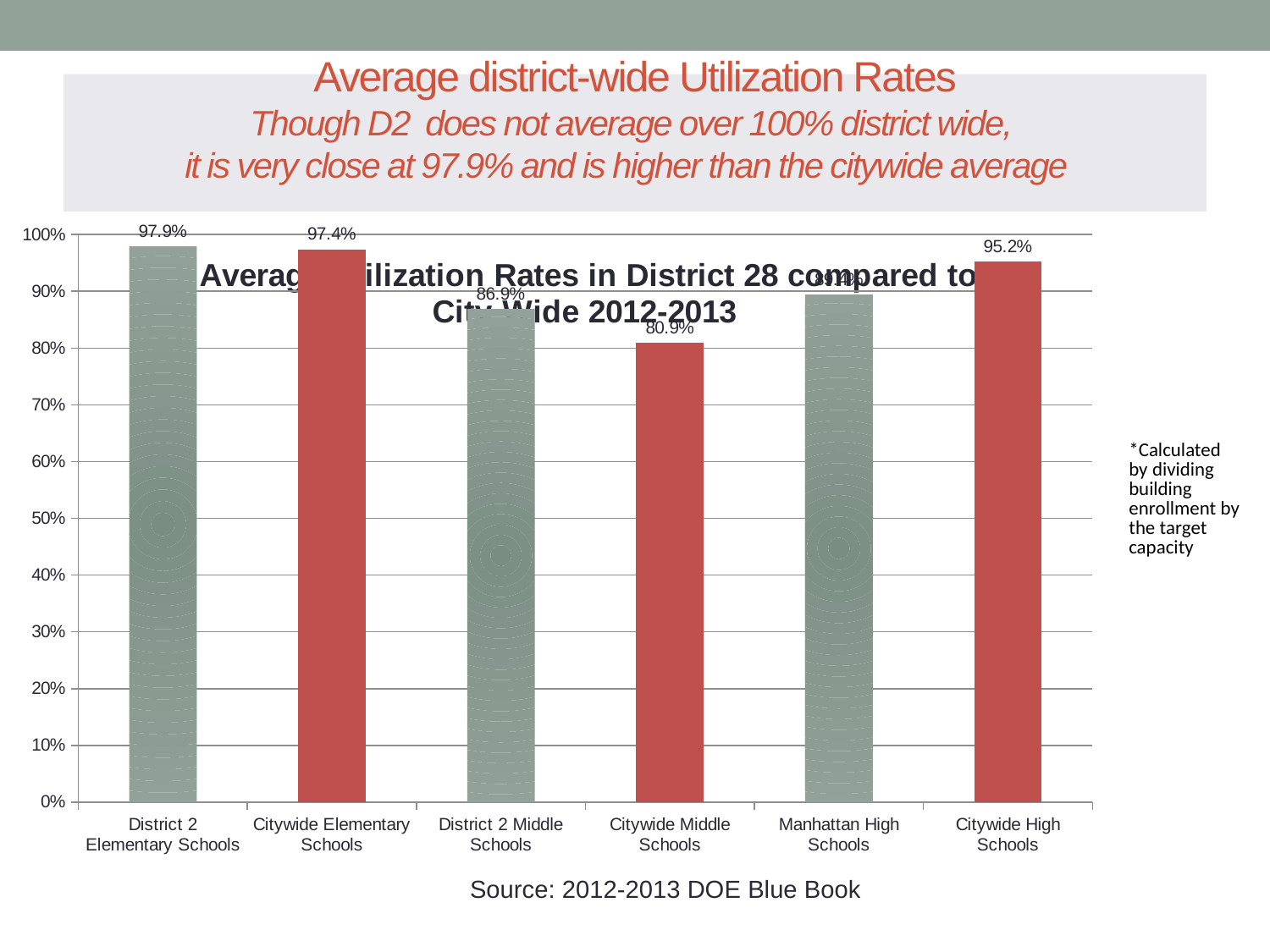
What is the utilization rate for Citywide Middle Schools? 80.9% Which category has the lowest utilization rate? Citywide Middle Schools What is the utilization rate for Citywide Elementary Schools? 97.4% What is the utilization rate for District 2 Elementary Schools? 97.9% How many categories are shown on the x axis of the chart? 6 What is the utilization rate for Citywide High Schools? 95.2% What is the utilization rate for District 2 Middle Schools? 86.9% What kind of chart is shown on the slide? bar chart What is the difference between the utilization rates of District 2 Middle Schools and Citywide Middle Schools? 6.0 percentage points Is the value for Manhattan High Schools greater or less than 80%? greater Which category has the highest utilization rate? District 2 Elementary Schools Which is larger, the utilization rate for Citywide High Schools or for Citywide Middle Schools? Citywide High Schools